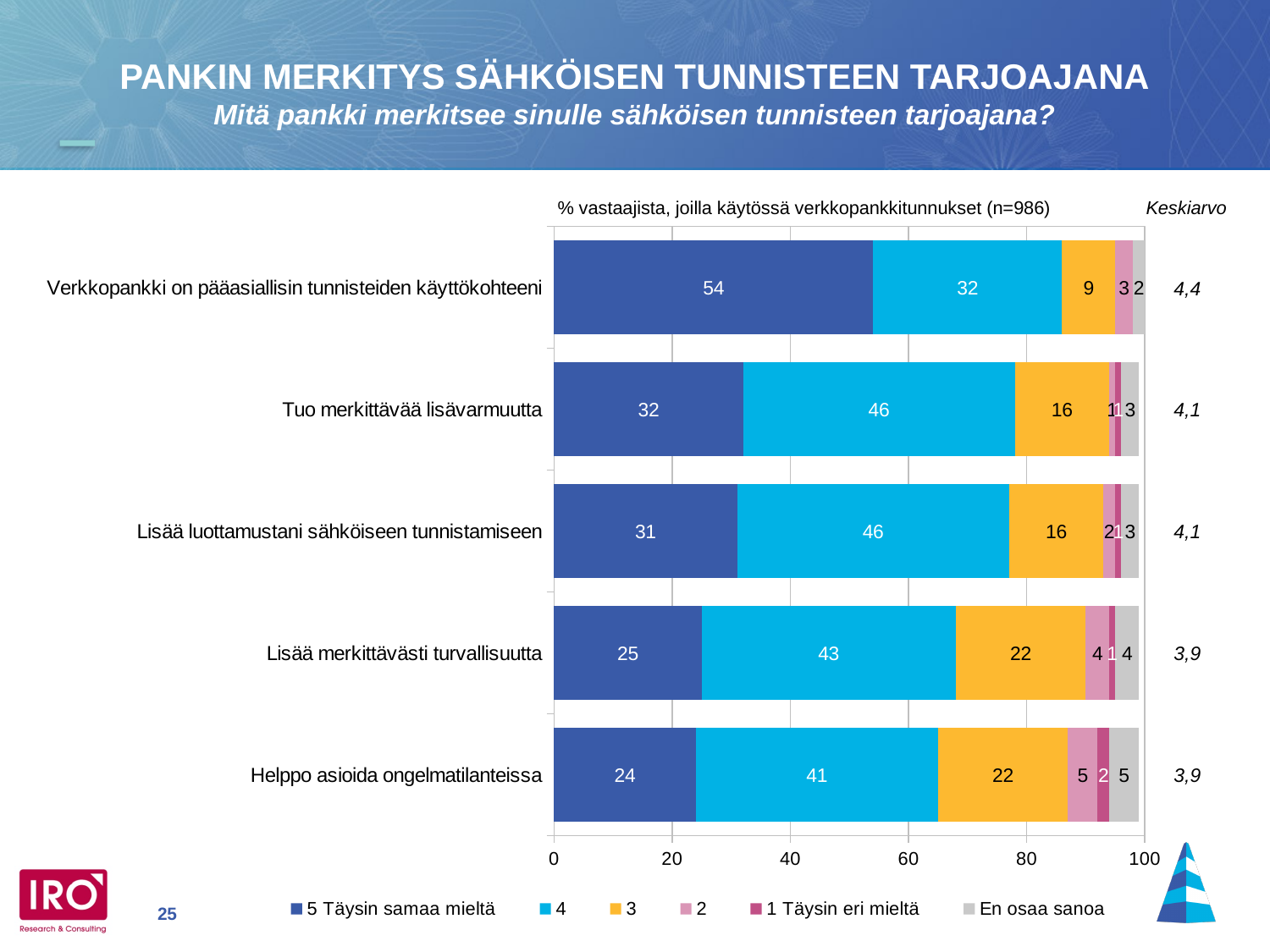
What percentage of respondents answered "5 Täysin samaa mieltä" for "Verkkopankki on pääasiallisin tunnisteiden käyttökohteeni"? 54 What is the difference between the "5 Täysin samaa mieltä" values for "Verkkopankki on pääasiallisin tunnisteiden käyttökohteeni" and "Helppo asioida ongelmatilanteissa"? 30 Which statement has the highest "5 Täysin samaa mieltä" share? Verkkopankki on pääasiallisin tunnisteiden käyttökohteeni How many statements (bars) are shown in the chart? 5 Which statement has the lowest "5 Täysin samaa mieltä" share? Helppo asioida ongelmatilanteissa What is the value of the "4" segment for "Tuo merkittävää lisävarmuutta"? 46 What kind of chart is shown on the slide? Stacked bar chart How many series does the legend list? 6 What is the Keskiarvo shown for "Verkkopankki on pääasiallisin tunnisteiden käyttökohteeni"? 4,4 What is the value of the "3" segment for "Helppo asioida ongelmatilanteissa"? 22 Which has a larger "4" segment: "Lisää luottamustani sähköiseen tunnistamiseen" or "Lisää merkittävästi turvallisuutta"? Lisää luottamustani sähköiseen tunnistamiseen What is the first entry in the chart legend? 5 Täysin samaa mieltä